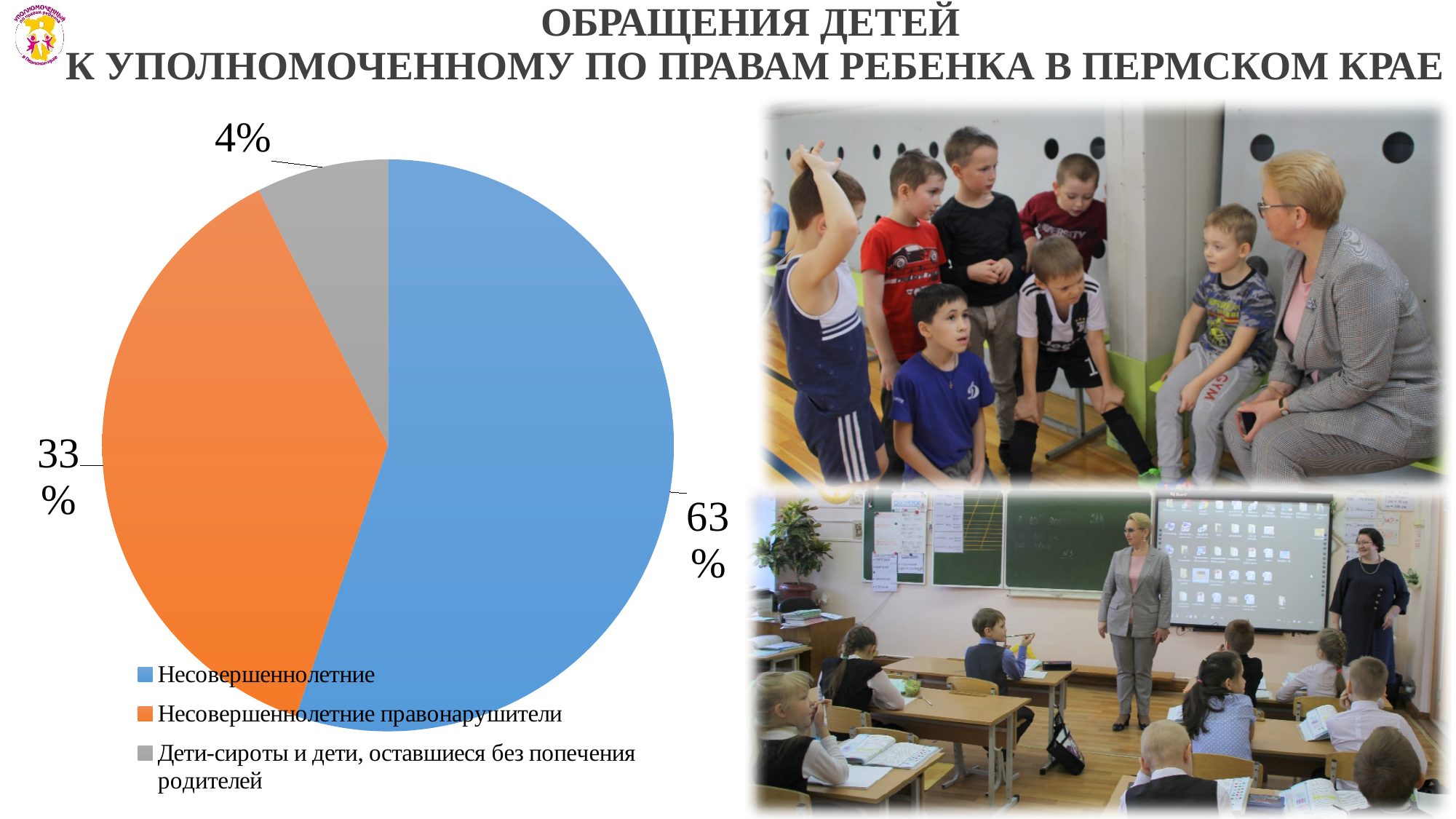
What share of the pie does "Несовершеннолетние правонарушители" have? 33% Which is larger: the share for "Несовершеннолетние" or for "Несовершеннолетние правонарушители"? Несовершеннолетние How many categories does the pie chart have? 3 What share of the pie does "Дети-сироты и дети, оставшиеся без попечения родителей" have? 4% What share of the pie does "Несовершеннолетние" have? 63% What colour is the slice for "Дети-сироты и дети, оставшиеся без попечения родителей"? grey Which category has the largest slice of the pie? Несовершеннолетние What is the difference in percentage points between "Несовершеннолетние правонарушители" and "Дети-сироты и дети, оставшиеся без попечения родителей"? 29 What is the difference in percentage points between "Несовершеннолетние" and "Несовершеннолетние правонарушители"? 30 What kind of chart is shown on the slide? pie chart What colour is the slice for "Несовершеннолетние правонарушители"? orange Which category has the smallest slice of the pie? Дети-сироты и дети, оставшиеся без попечения родителей